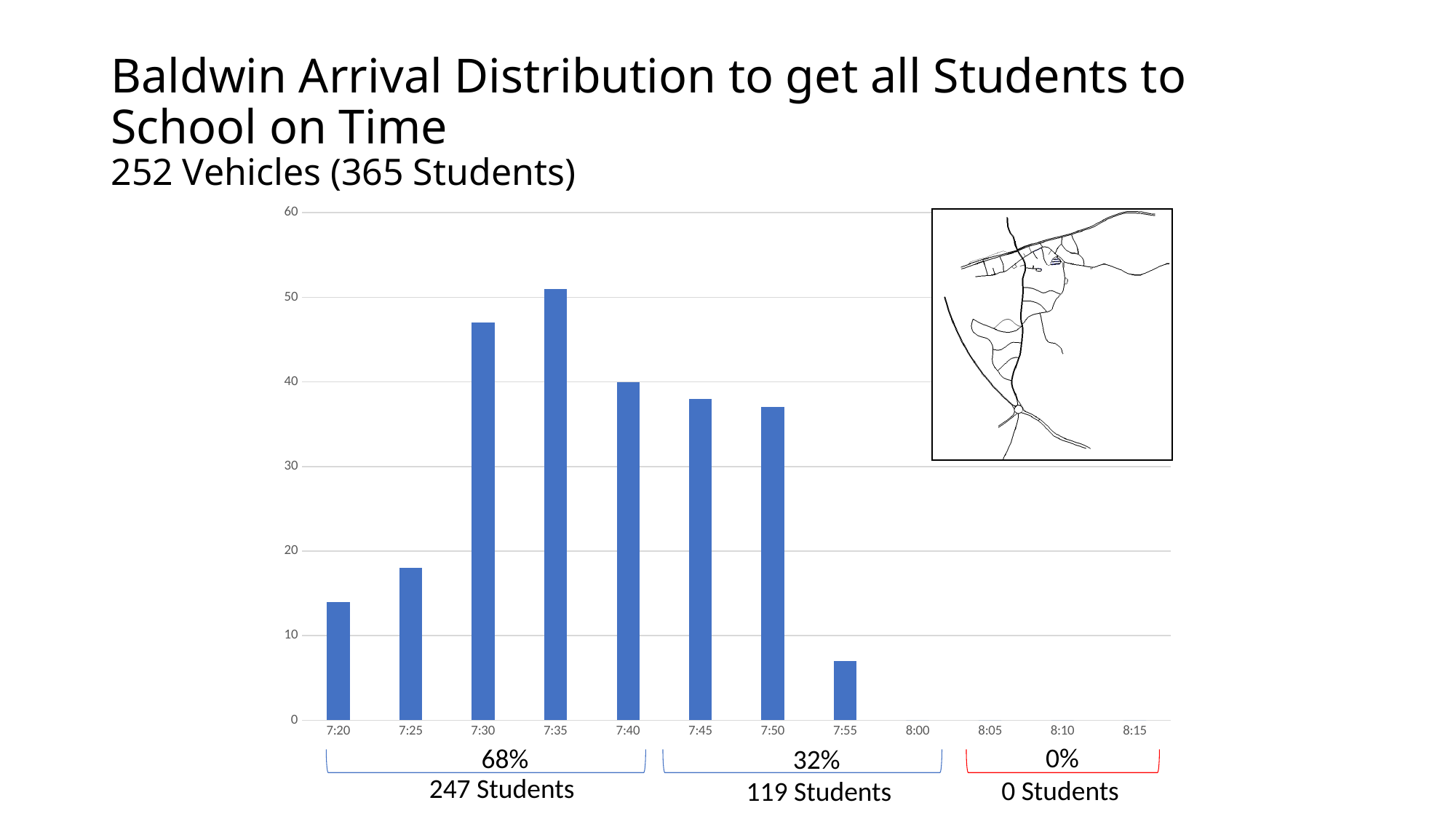
Is the value for 7:25 greater or less than 20? less How many bars are plotted on the chart? 8 Is the value for 7:30 greater or less than 40? greater How many time categories are labelled on the x axis? 12 Which arrival time has the lowest visible bar? 7:55 According to the annotation below the chart, what percentage of students arrive between 7:20 and 7:40? 68% Do the values rise or fall from 7:35 to 7:55? fall Which arrival time has the highest bar? 7:35 Is the value for 7:55 greater or less than 10? less What kind of chart is shown on the slide? bar chart Which is larger, the value for 7:30 or the value for 7:35? 7:35